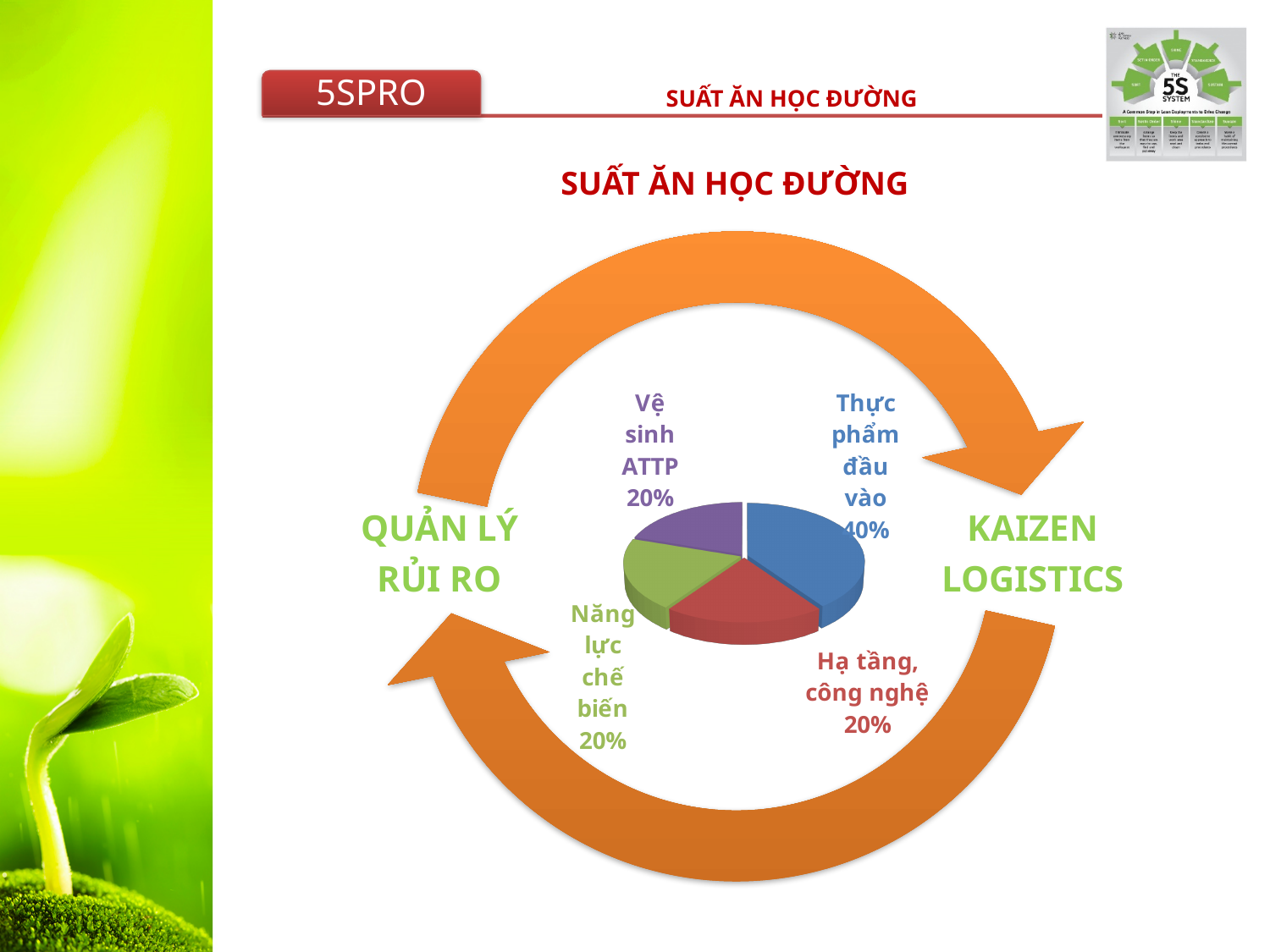
What percentage is shown for Năng lực chế biến? 20% What colour is the Thực phẩm đầu vào slice of the pie chart? Blue How many slices does the pie chart have? 4 Which is larger, the share for Thực phẩm đầu vào or the share for Hạ tầng, công nghệ? Thực phẩm đầu vào What is the combined share of Năng lực chế biến and Vệ sinh ATTP? 40% What percentage is shown for Thực phẩm đầu vào? 40% What is the difference between the share for Thực phẩm đầu vào and the share for Vệ sinh ATTP? 20% What percentage is shown for Vệ sinh ATTP? 20% What percentage is shown for Hạ tầng, công nghệ? 20% What is the title shown above the pie chart? SUẤT ĂN HỌC ĐƯỜNG What kind of chart is shown on the slide? Pie chart Which slice of the pie chart is the largest? Thực phẩm đầu vào